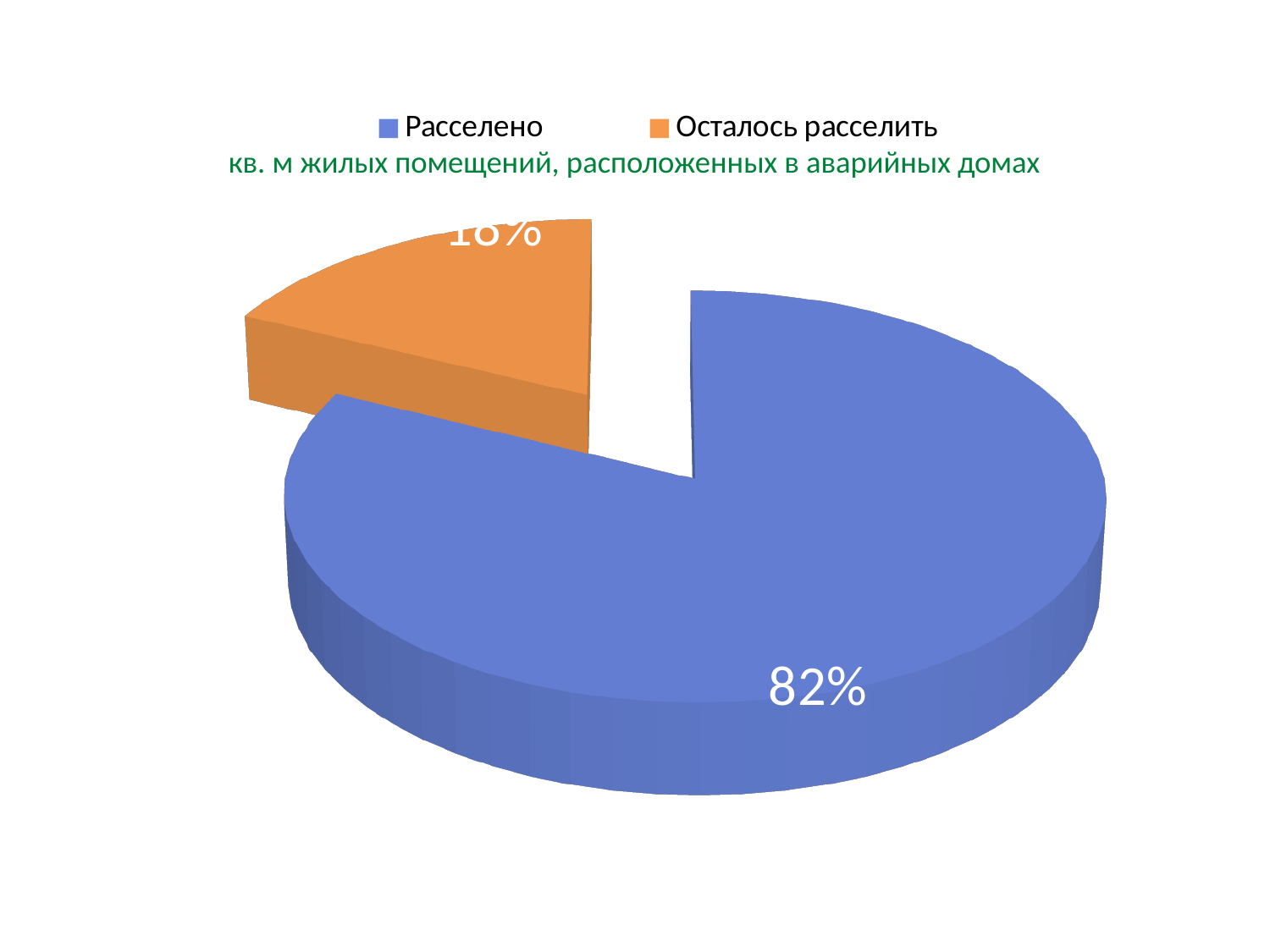
What colour is the "Осталось расселить" slice? orange What is the title of the chart? кв. м жилых помещений, расположенных в аварийных домах How many entries does the legend list? 2 What kind of chart is shown on the slide? pie chart How many slices does the pie chart have? 2 What share of the pie does the "Расселено" slice represent? 82% What is the difference in percentage points between the "Расселено" and "Осталось расселить" slices? 64 Which is larger: the "Расселено" slice or the "Осталось расселить" slice? Расселено Which slice is the smallest in the pie chart? Осталось расселить Which slice is the largest in the pie chart? Расселено What share of the pie does the "Осталось расселить" slice represent? 18%